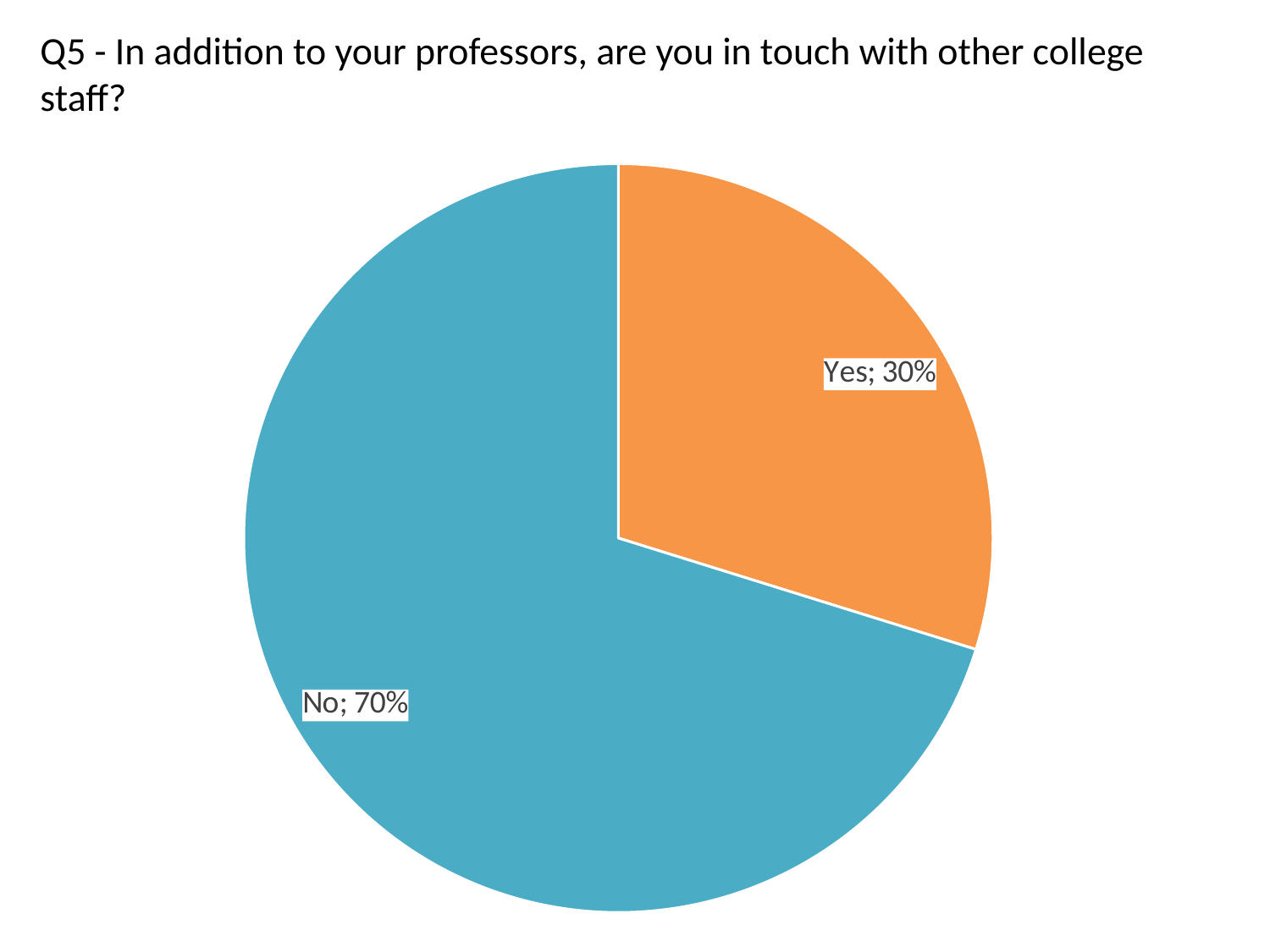
How many slices does the pie chart have? 2 Which slice is larger, "Yes" or "No"? No Which response has the largest share of the pie? No What is the title of the chart? Q5 - In addition to your professors, are you in touch with other college staff? What kind of chart is shown on the slide? pie chart What share of the pie does the "No" slice represent? 70% What percentage of respondents answered "No"? 70% What percentage of respondents answered "Yes"? 30% What colour is the "Yes" slice? orange What is the difference in percentage points between the "No" and "Yes" slices? 40 Which response has the smallest share of the pie? Yes